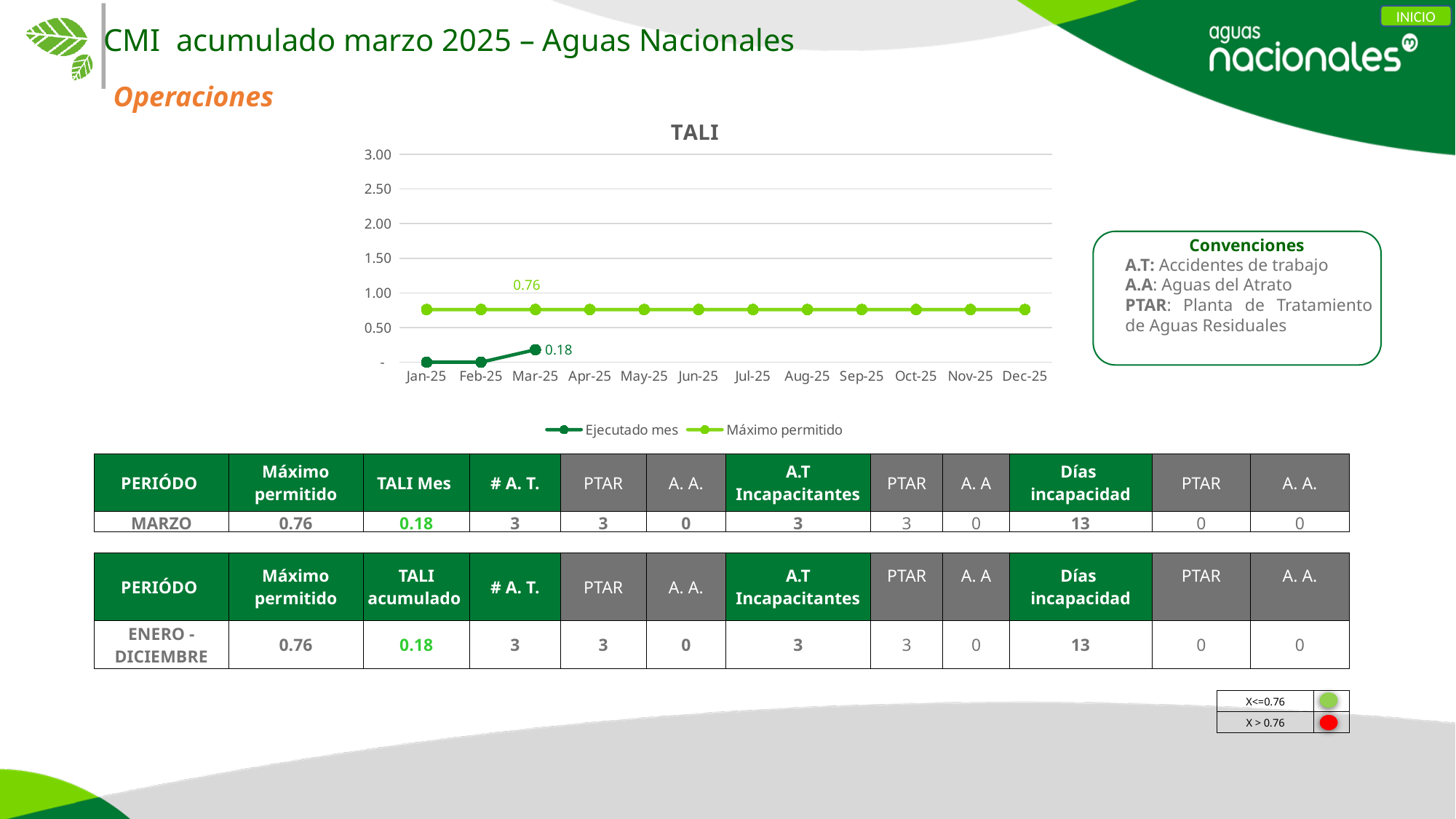
In the TALI chart, which is larger for Mar-25: Ejecutado mes or Máximo permitido? Máximo permitido What is the title of the chart on the slide? TALI How many months are shown on the x axis of the TALI chart? 12 How many series does the legend of the TALI chart list? 2 Does the Ejecutado mes line in the TALI chart rise or fall from Jan-25 to Mar-25? rise Is the Máximo permitido value in the TALI chart greater or less than 1.00? less What is the value of Ejecutado mes for Mar-25 in the TALI chart? 0.18 What is the value of the Máximo permitido line in the TALI chart? 0.76 Which month has the highest Ejecutado mes value in the TALI chart? Mar-25 In the TALI chart, what is the difference between Máximo permitido (0.76) and Ejecutado mes for Mar-25 (0.18)? 0.58 Is the Ejecutado mes value for Mar-25 in the TALI chart greater or less than 0.50? less What kind of chart is the TALI chart? line chart